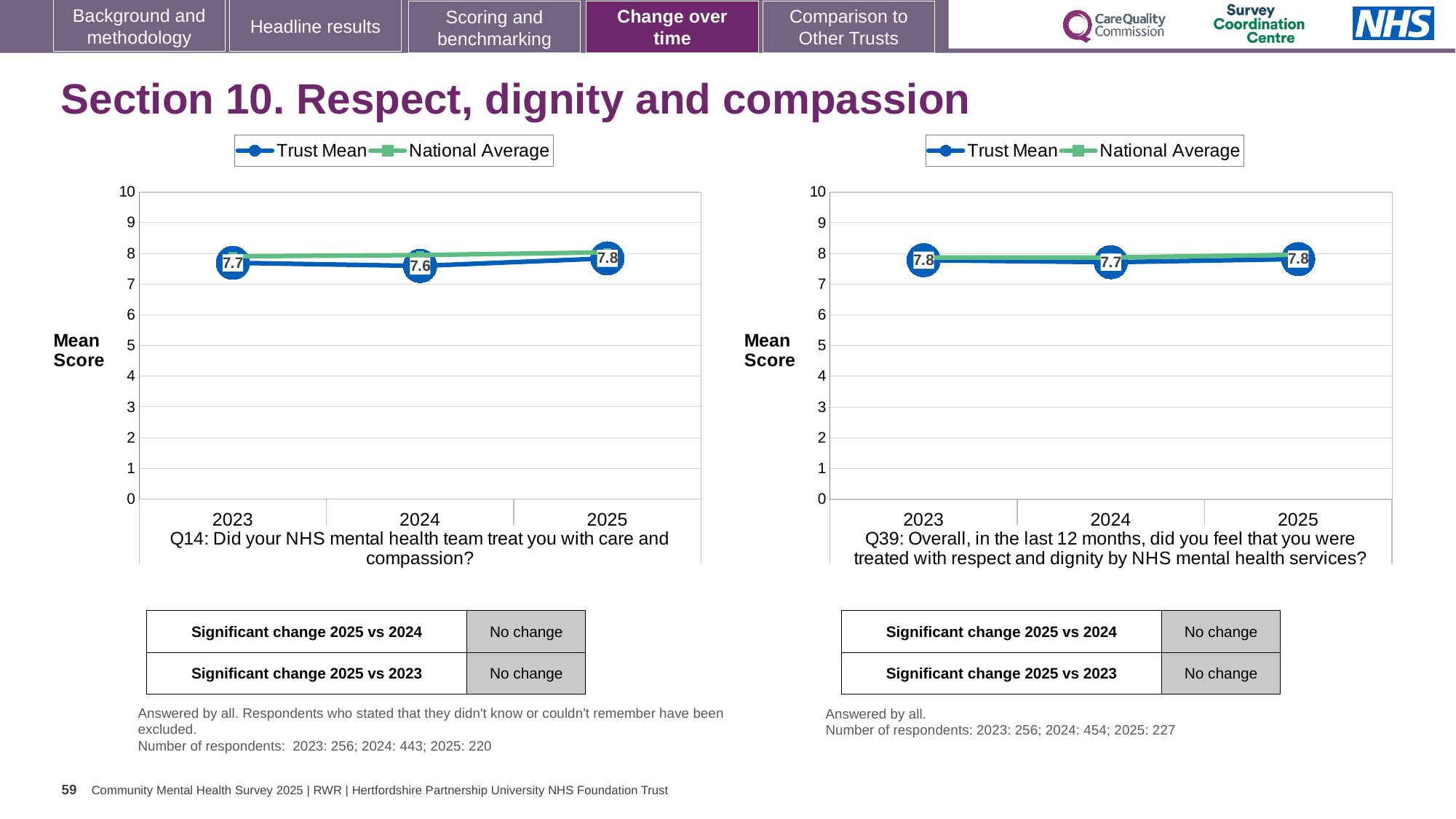
In the right chart (Q39), which is larger, the Trust Mean for 2023 or for 2024? 2023 In the right chart (Q39), what is the Trust Mean for 2025? 7.8 What are the two series named in the legend of the right chart (Q39)? Trust Mean and National Average In the left chart (Q14), which year has the highest Trust Mean? 2025 What kind of chart is the right chart (Q39)? Line chart In the left chart (Q14), what is the difference between the Trust Mean for 2025 and 2024? 0.2 In the left chart (Q14), is the National Average for 2025 greater or less than 5? greater In the left chart (Q14), which year has the lowest Trust Mean? 2024 How many years are plotted on the x axis of the right chart (Q39)? 3 In the left chart (Q14), what is the Trust Mean for 2024? 7.6 In the right chart (Q39), which year has the lowest Trust Mean? 2024 How many series does the legend of the left chart (Q14) list? 2